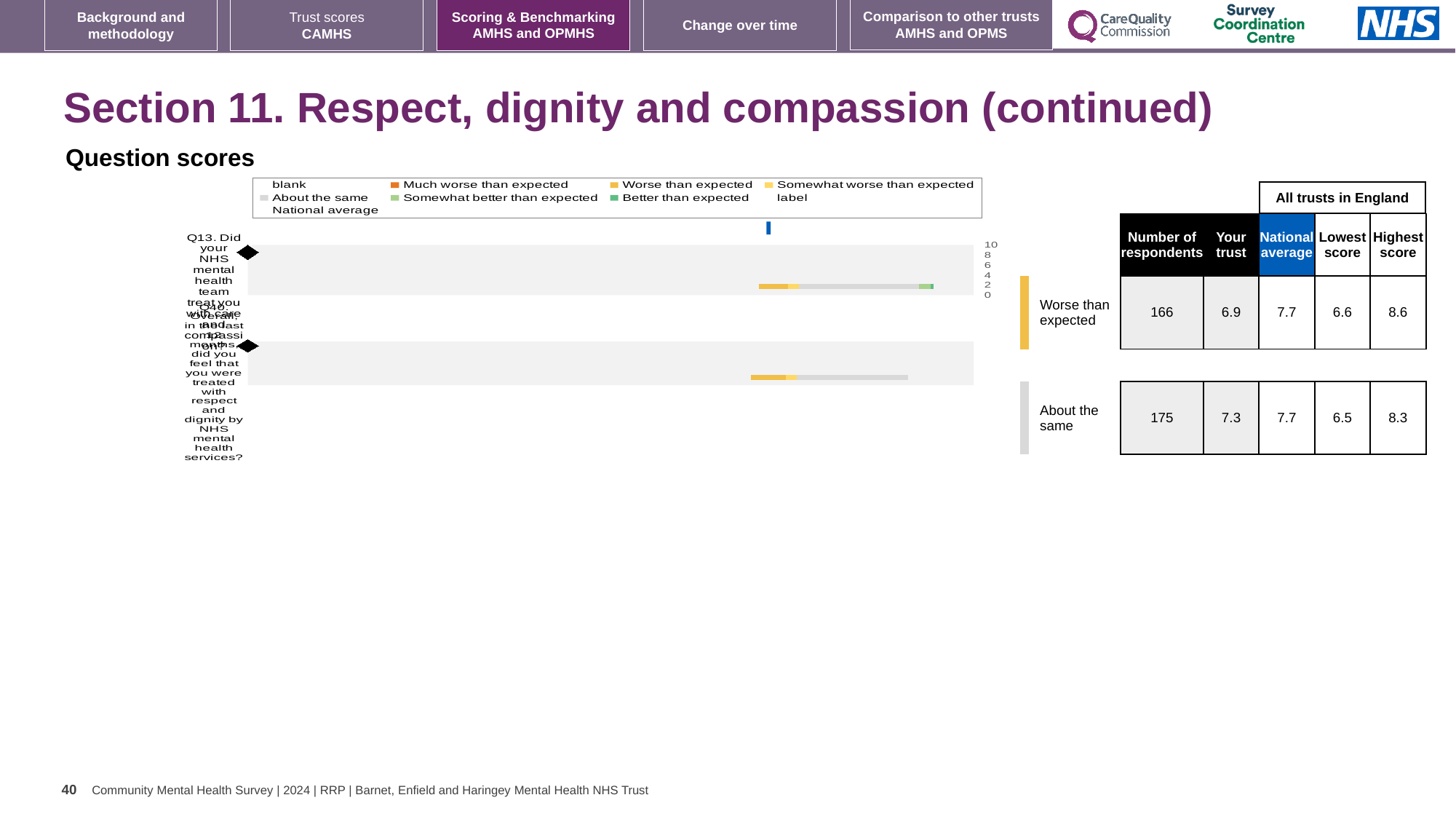
What is the heading above the chart on this slide? Question scores Which question has the higher 'Your trust' score, Q13 or Q10? Q10 What is the highest score across all trusts in England for Q10? 8.3 What kind of chart is used to show the question scores on this slide? bar chart How many questions (categories) are plotted in the question scores chart? 2 In the table beside the chart, how many respondents are listed for Q13 (the 'Worse than expected' row)? 166 What is the national average score shown for Q13? 7.7 By how much is the national average (7.7) above the trust's score (7.3) for Q10? 0.4 What is the 'Your trust' score for Q10 (the 'About the same' row)? 7.3 What is the difference between the highest score (8.6) and the lowest score (6.6) for Q13? 2.0 Which question is rated 'Worse than expected' on this slide? Q13 Which question has the larger number of respondents? Q10